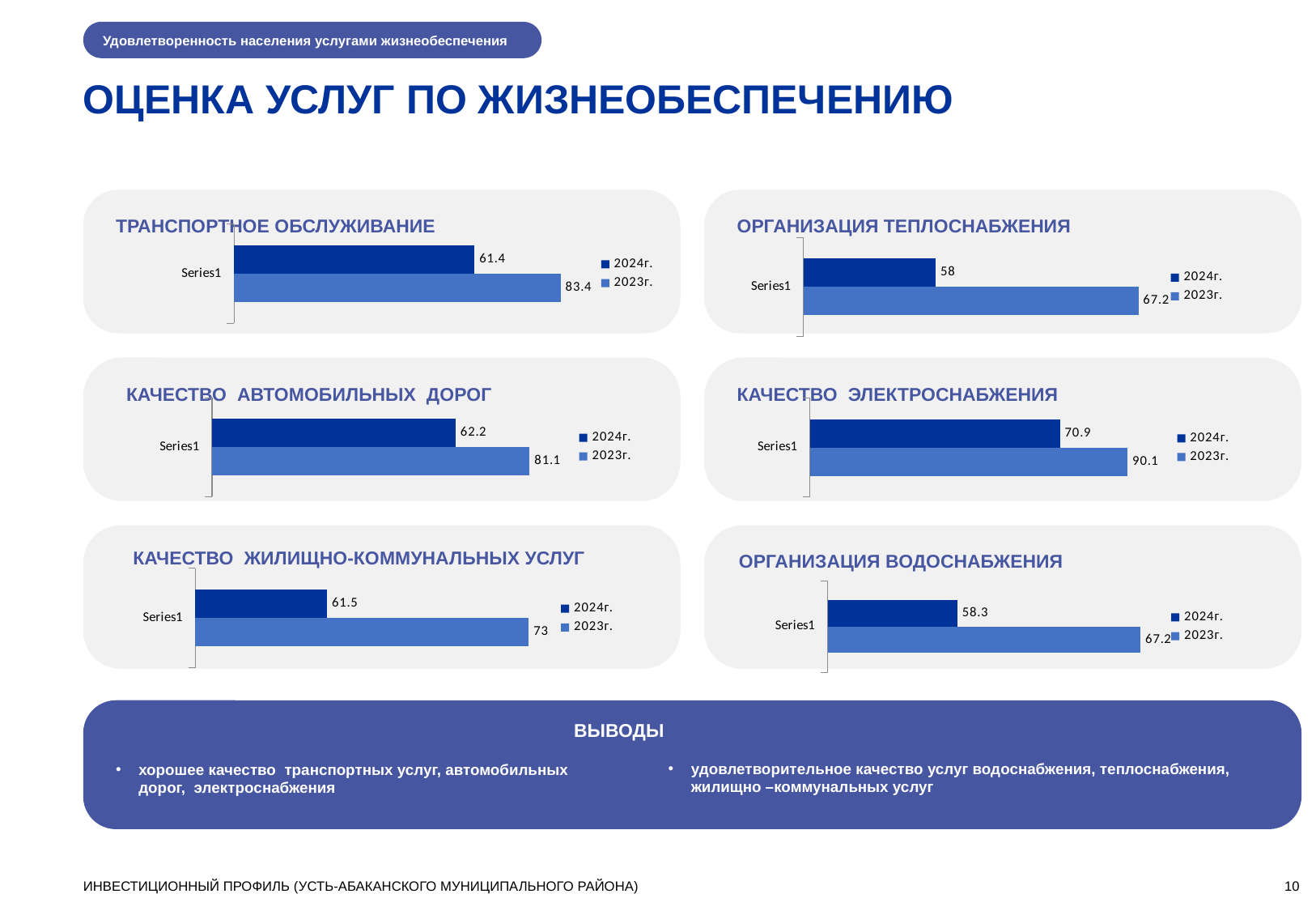
In the 'ТРАНСПОРТНОЕ ОБСЛУЖИВАНИЕ' chart, what is the value for 2024г.? 61.4 In the 'ОРГАНИЗАЦИЯ ТЕПЛОСНАБЖЕНИЯ' chart, what is the value for 2024г.? 58 In the 'ОРГАНИЗАЦИЯ ВОДОСНАБЖЕНИЯ' chart, what is the value for 2024г.? 58.3 In the 'ТРАНСПОРТНОЕ ОБСЛУЖИВАНИЕ' chart, what is the value for 2023г.? 83.4 How many series does the legend of the 'ТРАНСПОРТНОЕ ОБСЛУЖИВАНИЕ' chart list? 2 In the 'ОРГАНИЗАЦИЯ ВОДОСНАБЖЕНИЯ' chart, what is the difference between the 2023г. and 2024г. values? 8.9 How many charts are shown on the slide? 6 In the 'КАЧЕСТВО ЭЛЕКТРОСНАБЖЕНИЯ' chart, which series has the larger value, 2024г. or 2023г.? 2023г. In the 'КАЧЕСТВО ЖИЛИЩНО-КОММУНАЛЬНЫХ УСЛУГ' chart, what is the value for 2023г.? 73 What kind of chart is the 'ОРГАНИЗАЦИЯ ТЕПЛОСНАБЖЕНИЯ' chart? Bar chart In the 'КАЧЕСТВО ЭЛЕКТРОСНАБЖЕНИЯ' chart, what is the value for 2023г.? 90.1 In the 'КАЧЕСТВО АВТОМОБИЛЬНЫХ ДОРОГ' chart, what is the difference between the 2023г. and 2024г. values? 18.9